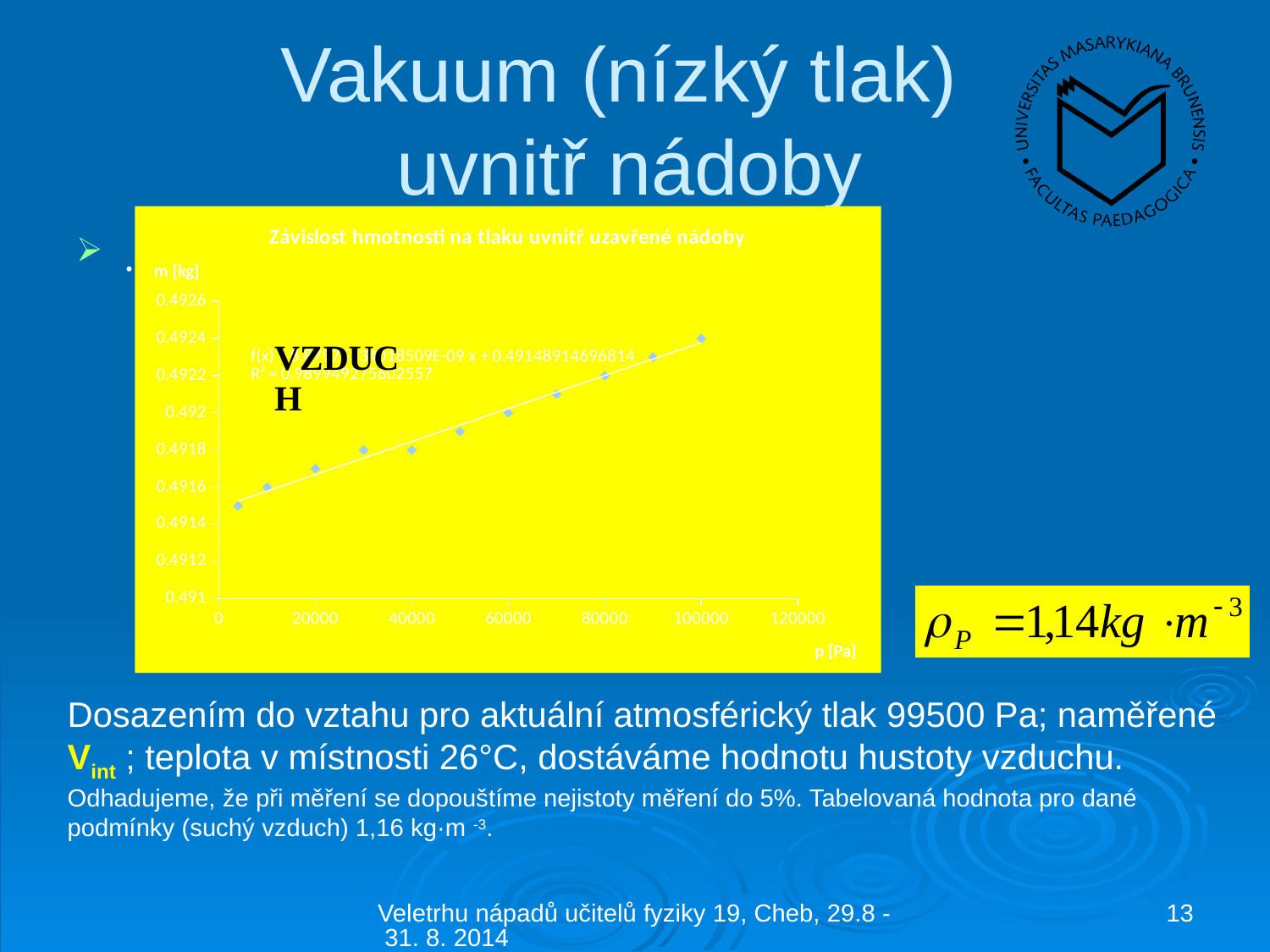
Is the mass value at about 60000 Pa greater or less than 0.4918 kg? greater What quantity and unit are shown on the vertical axis of the chart? m [kg] What is the title of the chart? Závislost hmotnosti na tlaku uvnitř uzavřené nádoby How many data points are plotted in the chart? 11 What is the highest tick value shown on the x axis (p [Pa])? 120000 Do the plotted mass values rise or fall as the pressure p increases along the x axis? rise Which plotted point has the highest mass: the one at the lowest pressure or the one at the highest pressure? the one at the highest pressure Is the mass value at the highest plotted pressure (about 100000 Pa) greater or less than 0.492 kg? greater What kind of chart is shown on the slide? scatter chart with a linear trend line Is the mass value at the lowest plotted pressure greater or less than 0.4918 kg? less